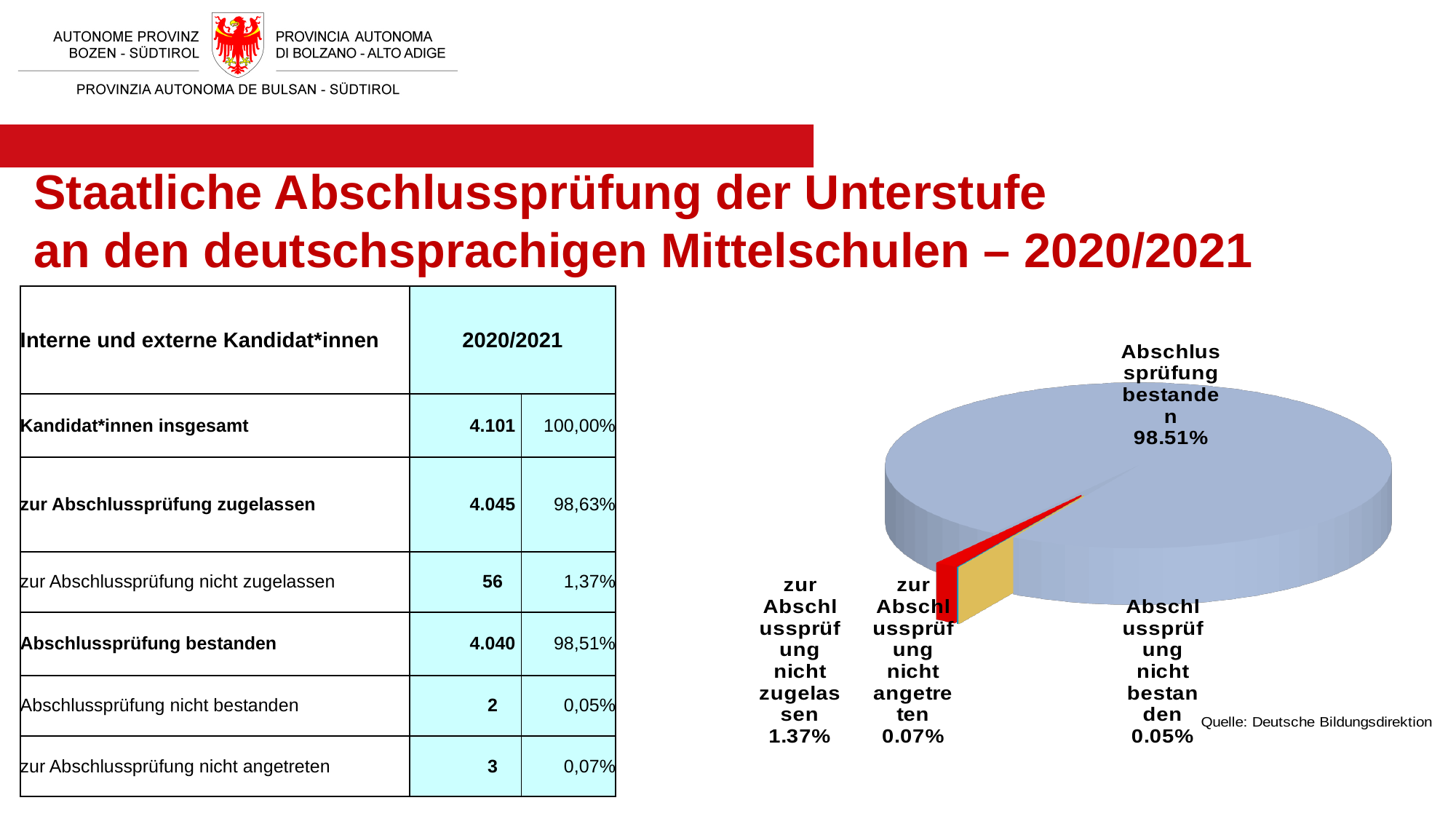
In the pie chart, what share is labelled for "Abschlussprüfung nicht bestanden"? 0.05% What kind of chart is shown on the right side of the slide? pie chart In the pie chart, what is the difference in percentage points between "zur Abschlussprüfung nicht zugelassen" and "zur Abschlussprüfung nicht angetreten"? 1.30% In the pie chart, what is the difference in percentage points between "zur Abschlussprüfung nicht angetreten" and "Abschlussprüfung nicht bestanden"? 0.02% Which slice of the pie chart is the largest? Abschlussprüfung bestanden In the pie chart, which is larger: "zur Abschlussprüfung nicht zugelassen" or "zur Abschlussprüfung nicht angetreten"? zur Abschlussprüfung nicht zugelassen Which slice of the pie chart is the smallest? Abschlussprüfung nicht bestanden What colour is the largest slice of the pie chart? light blue In the pie chart, what share is labelled for "Abschlussprüfung bestanden"? 98.51% In the pie chart, what share is labelled for "zur Abschlussprüfung nicht zugelassen"? 1.37% In the pie chart, what share is labelled for "zur Abschlussprüfung nicht angetreten"? 0.07% How many slices does the pie chart have? 4